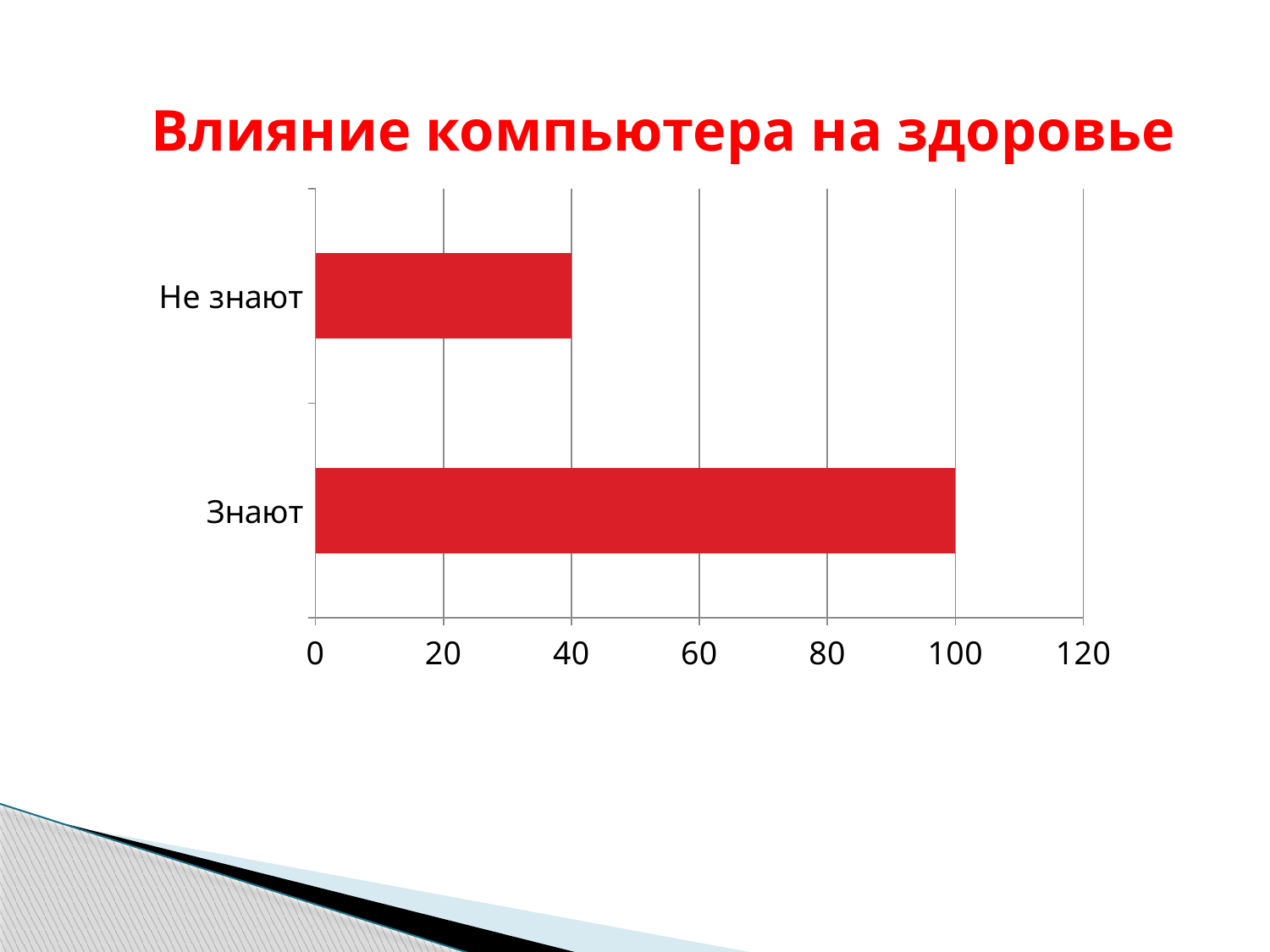
What is the difference between the values for Знают and Не знают? 60 What is the title of the slide? Влияние компьютера на здоровье What is the value for Не знают? 40 How many categories are shown in the chart? 2 Is the value for Знают greater or less than 80? greater Which is larger, the value for Знают or the value for Не знают? Знают Which category has the lowest value? Не знают What kind of chart is shown on the slide? bar chart What is the maximum value shown on the horizontal axis? 120 Is the value for Не знают greater or less than 60? less What is the value for Знают? 100 Which category has the highest value? Знают